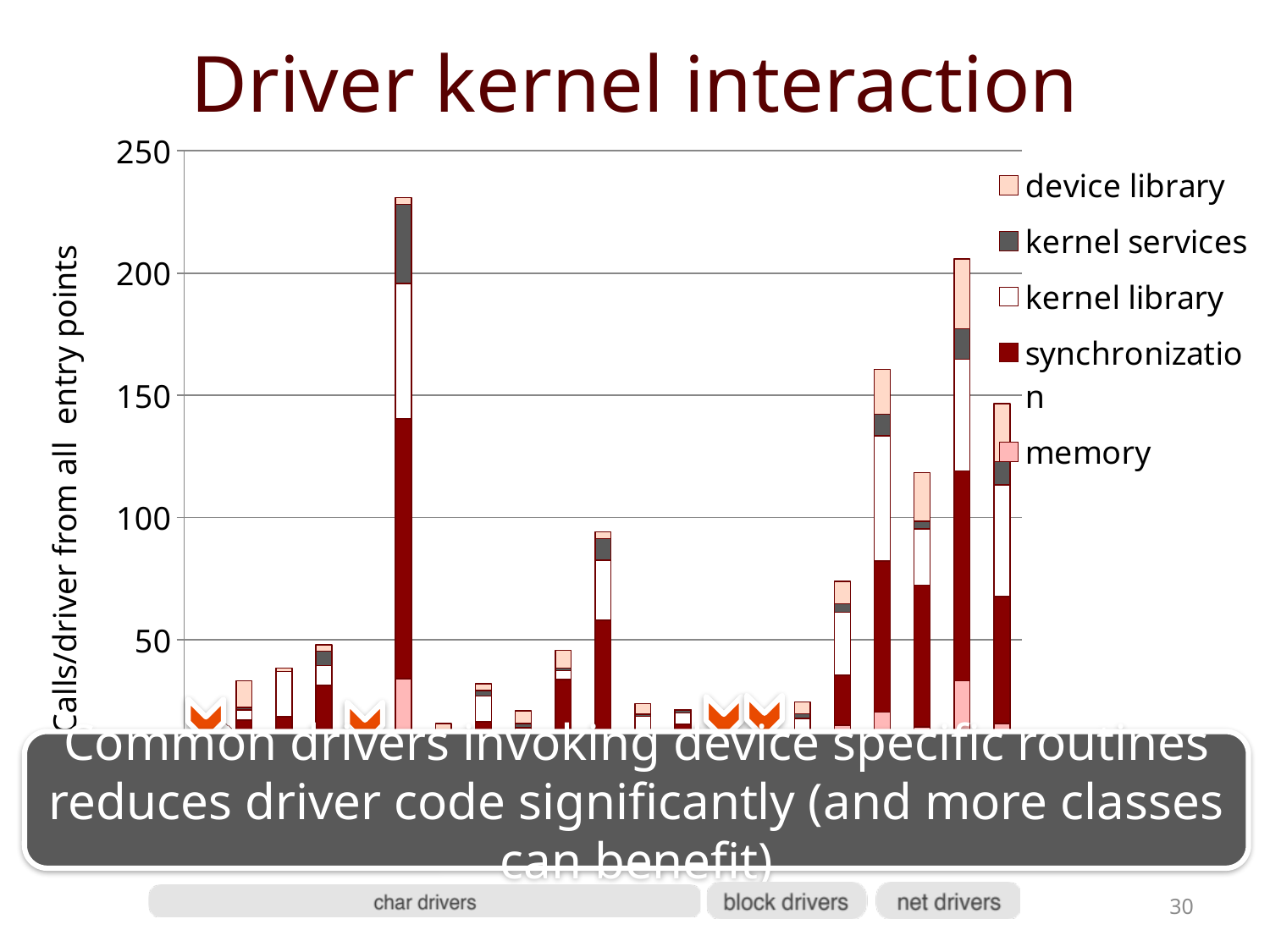
What kind of chart is shown on the slide? stacked bar chart Is the total of the tallest bar in the chart greater or less than 250? less What is the title of the chart? Driver kernel interaction How many series does the legend list? 5 Is the total of the tallest bar in the net drivers group greater or less than 200? greater Which driver group contains the tallest bar in the chart: char drivers, block drivers, or net drivers? char drivers Is the total of the tallest bar in the block drivers group greater or less than 50? greater What is the label on the vertical axis of the chart? Calls/driver from all entry points What is the highest value shown on the vertical axis of the chart? 250